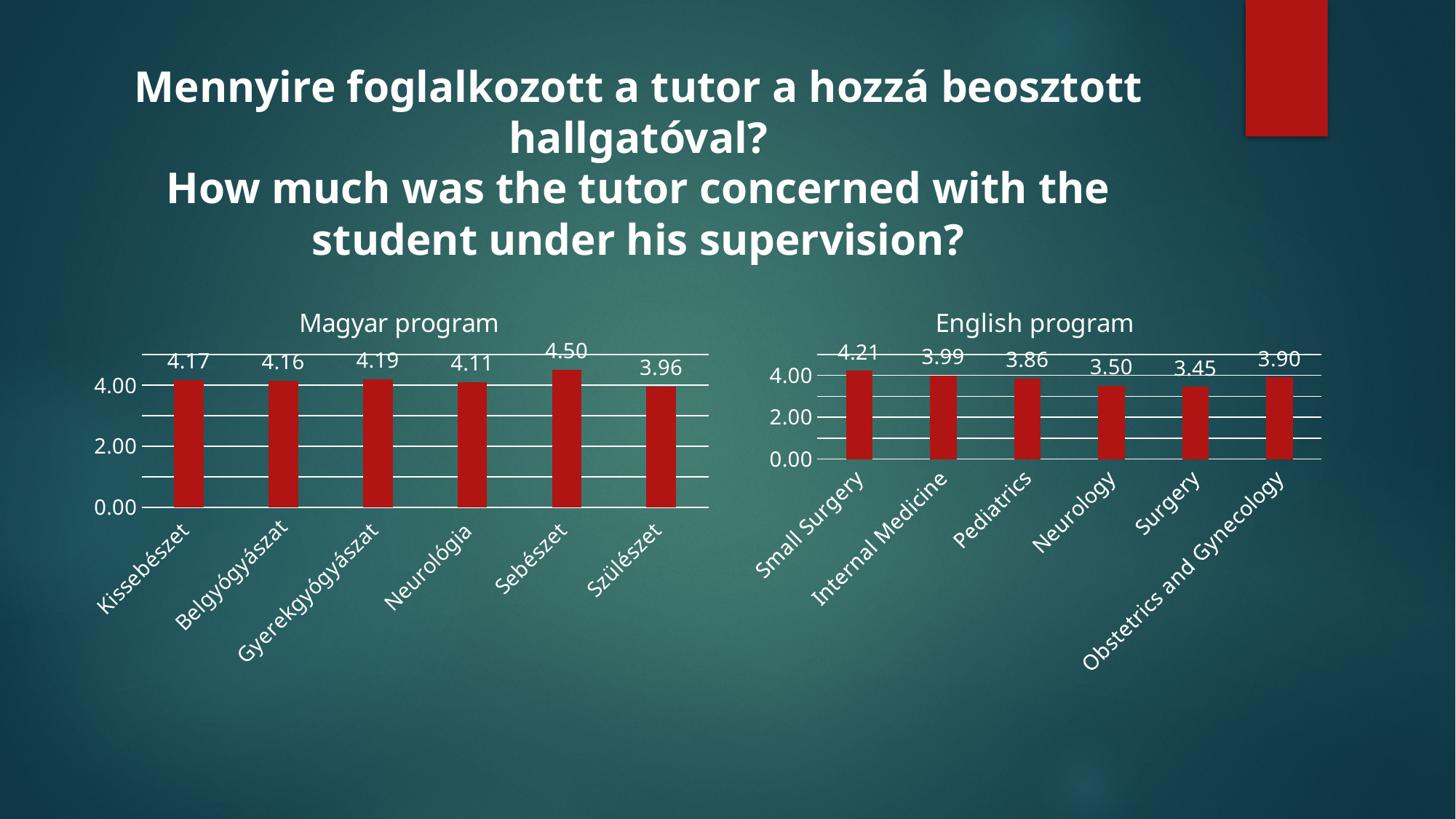
In the Magyar program chart, what is the difference between Sebészet and Szülészet? 0.54 How many categories are shown in the Magyar program chart? 6 In the English program chart, which category has the highest value? Small Surgery In the Magyar program chart, which category has the highest value? Sebészet In the Magyar program chart, what is the value for Sebészet? 4.50 In the English program chart, which is larger, Internal Medicine or Pediatrics? Internal Medicine In the English program chart, what is the value for Neurology? 3.50 In the Magyar program chart, which category has the lowest value? Szülészet What kind of chart is the English program chart? Bar chart In the Magyar program chart, what is the value for Gyerekgyógyászat? 4.19 In the English program chart, what is the difference between Small Surgery and Surgery? 0.76 In the English program chart, which category has the lowest value? Surgery